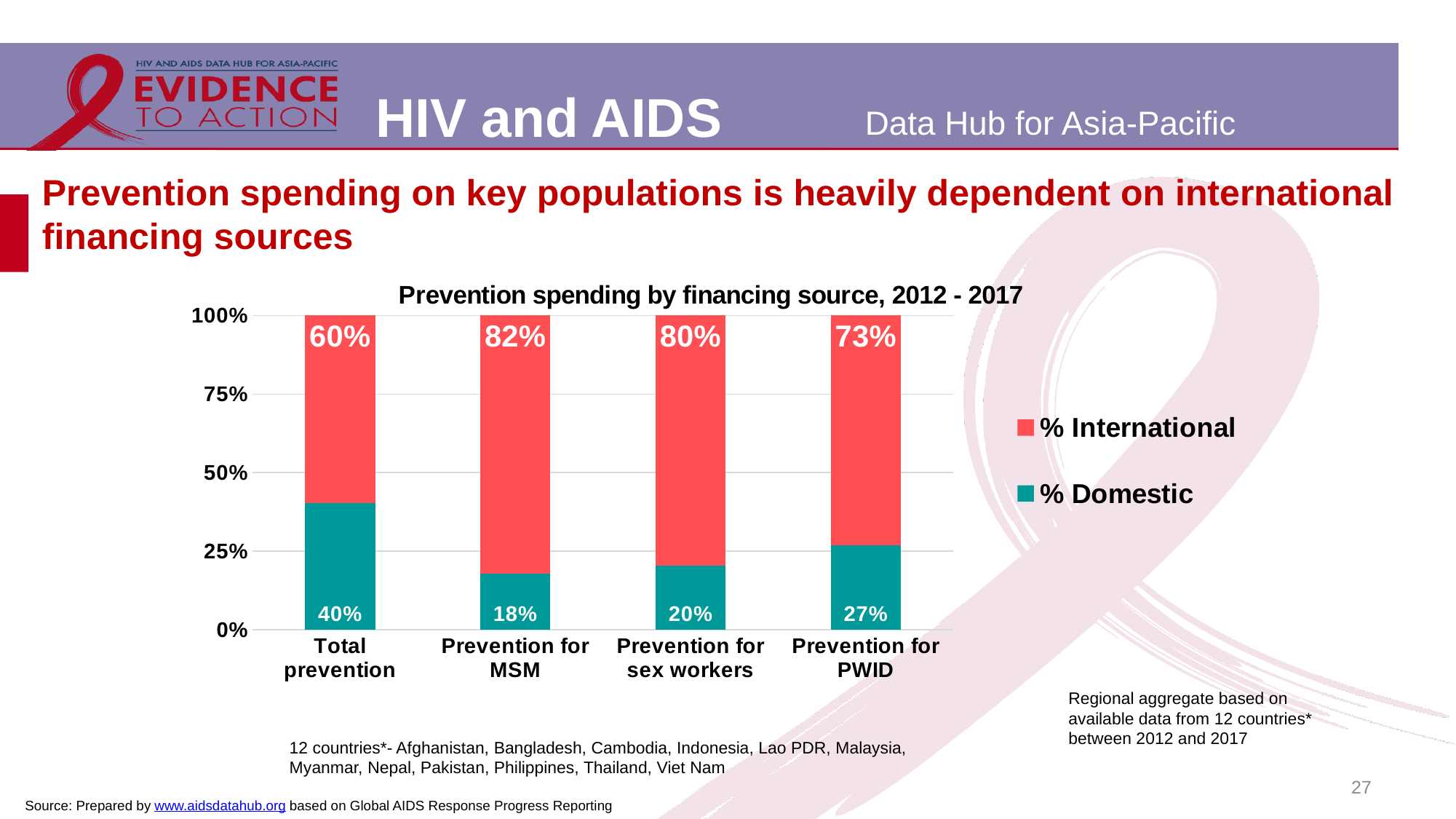
What is the title of the chart? Prevention spending by financing source, 2012 - 2017 How many categories are shown on the x axis? 4 Which category has the highest % International share? Prevention for MSM What kind of chart is shown on the slide? Stacked bar chart What is the % Domestic value for Total prevention? 40% What is the % International value for Prevention for sex workers? 80% What is the difference between the % International values for Prevention for MSM and Total prevention? 22 percentage points Which is larger, the % Domestic value for Prevention for sex workers or for Prevention for PWID? Prevention for PWID What is the % International value for Prevention for MSM? 82% How many series does the legend list? 2 Which category has the lowest % Domestic share? Prevention for MSM What is the % Domestic value for Prevention for PWID? 27%